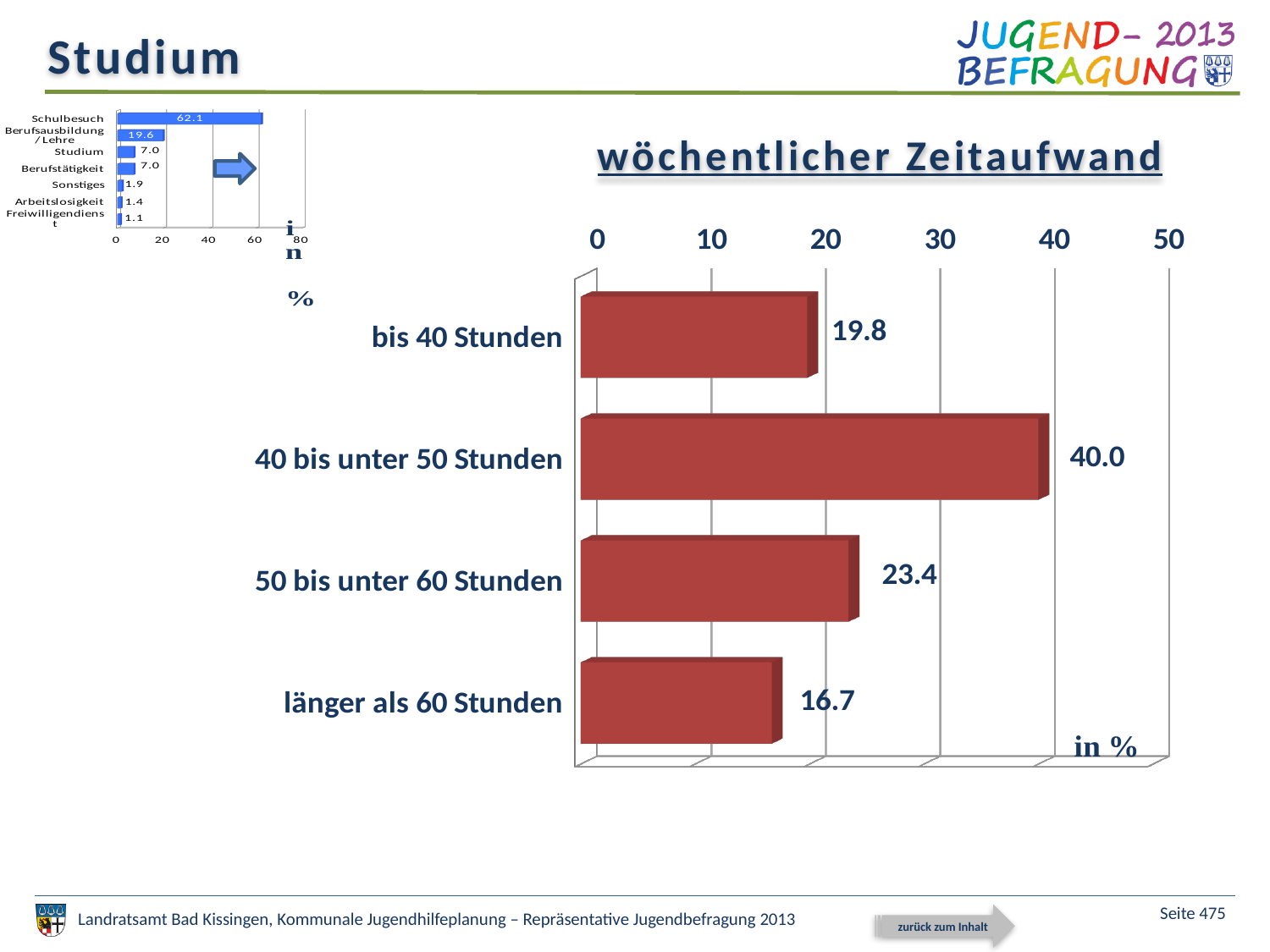
What kind of chart is the 'wöchentlicher Zeitaufwand' chart? bar chart In the 'wöchentlicher Zeitaufwand' chart, which category has the lowest value? länger als 60 Stunden How many categories does the small blue chart at the top left show? 7 In the 'wöchentlicher Zeitaufwand' chart, what is the value for 'länger als 60 Stunden'? 16.7 In the 'wöchentlicher Zeitaufwand' chart, what is the difference between '50 bis unter 60 Stunden' and 'bis 40 Stunden'? 3.6 In the small blue chart at the top left, what is the value for 'Schulbesuch'? 62.1 How many categories does the 'wöchentlicher Zeitaufwand' chart show? 4 In the small blue chart at the top left, which category has the highest value? Schulbesuch In the 'wöchentlicher Zeitaufwand' chart, which category has the highest value? 40 bis unter 50 Stunden In the 'wöchentlicher Zeitaufwand' chart, what is the value for '40 bis unter 50 Stunden'? 40.0 In the 'wöchentlicher Zeitaufwand' chart, which is larger: 'bis 40 Stunden' or '50 bis unter 60 Stunden'? 50 bis unter 60 Stunden In the small blue chart at the top left, what is the value for 'Berufsausbildung / Lehre'? 19.6